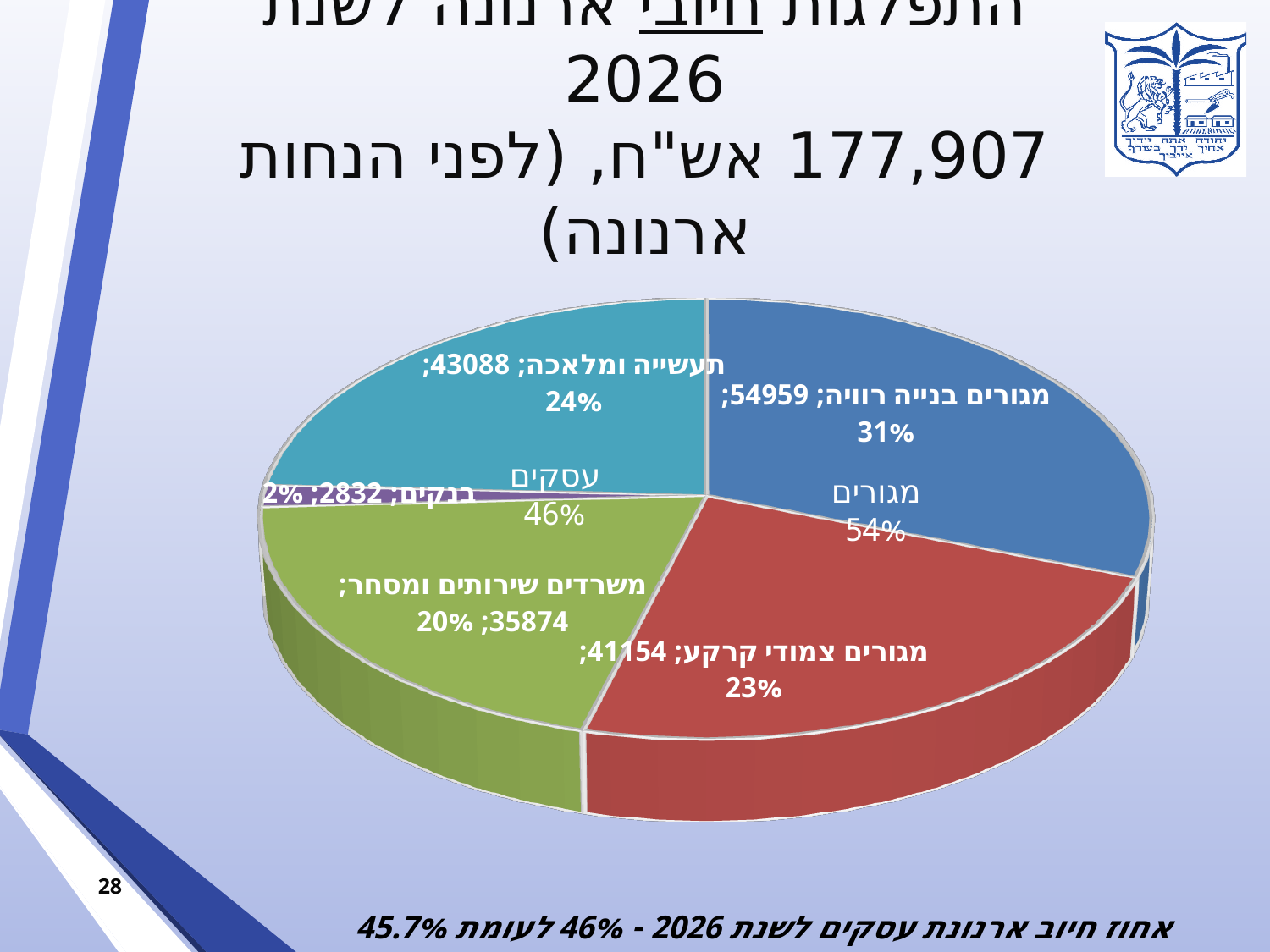
What total amount in אש"ח is stated in the slide title? 177,907 Which category has the smallest slice of the pie chart? בנקים What percentage share does תעשייה ומלאכה have in the pie chart? 24% What kind of chart is shown on the slide? pie chart How many slices does the pie chart have? 5 What is the difference between the values for מגורים בנייה רוויה and מגורים צמודי קרקע? 13805 What percentage share does בנקים have in the pie chart? 2% What value is shown for משרדים שירותים ומסחר? 35874 Which is larger, the value for תעשייה ומלאכה or the value for משרדים שירותים ומסחר? תעשייה ומלאכה Which category has the largest slice of the pie chart? מגורים בנייה רוויה What value is shown for מגורים בנייה רוויה? 54959 What percentage share does מגורים צמודי קרקע have in the pie chart? 23%